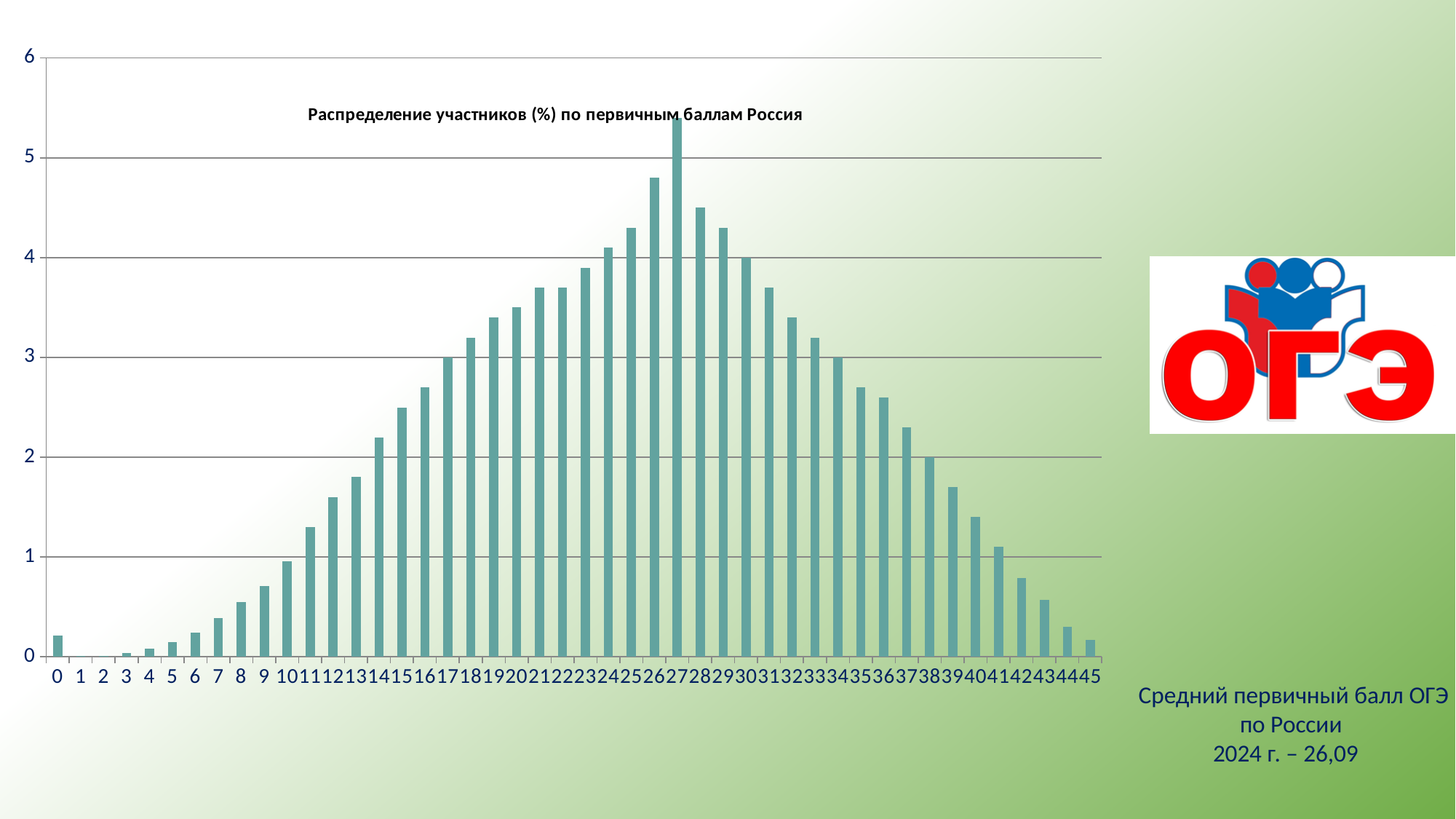
Is the value for score 20 greater or less than 3? greater How many score categories are shown along the x axis of the chart? 46 What is the title of the chart? Распределение участников (%) по первичным баллам Россия Which is larger, the value for score 27 or the value for score 28? 27 Which primary score has the highest share of participants? 27 Is the value for score 35 greater or less than 3? less Do the values rise or fall along the x axis from score 27 to score 45? fall What kind of chart is shown on the slide? bar chart Which is larger, the value for score 10 or the value for score 40? 40 Is the value for score 27 greater or less than 5? greater